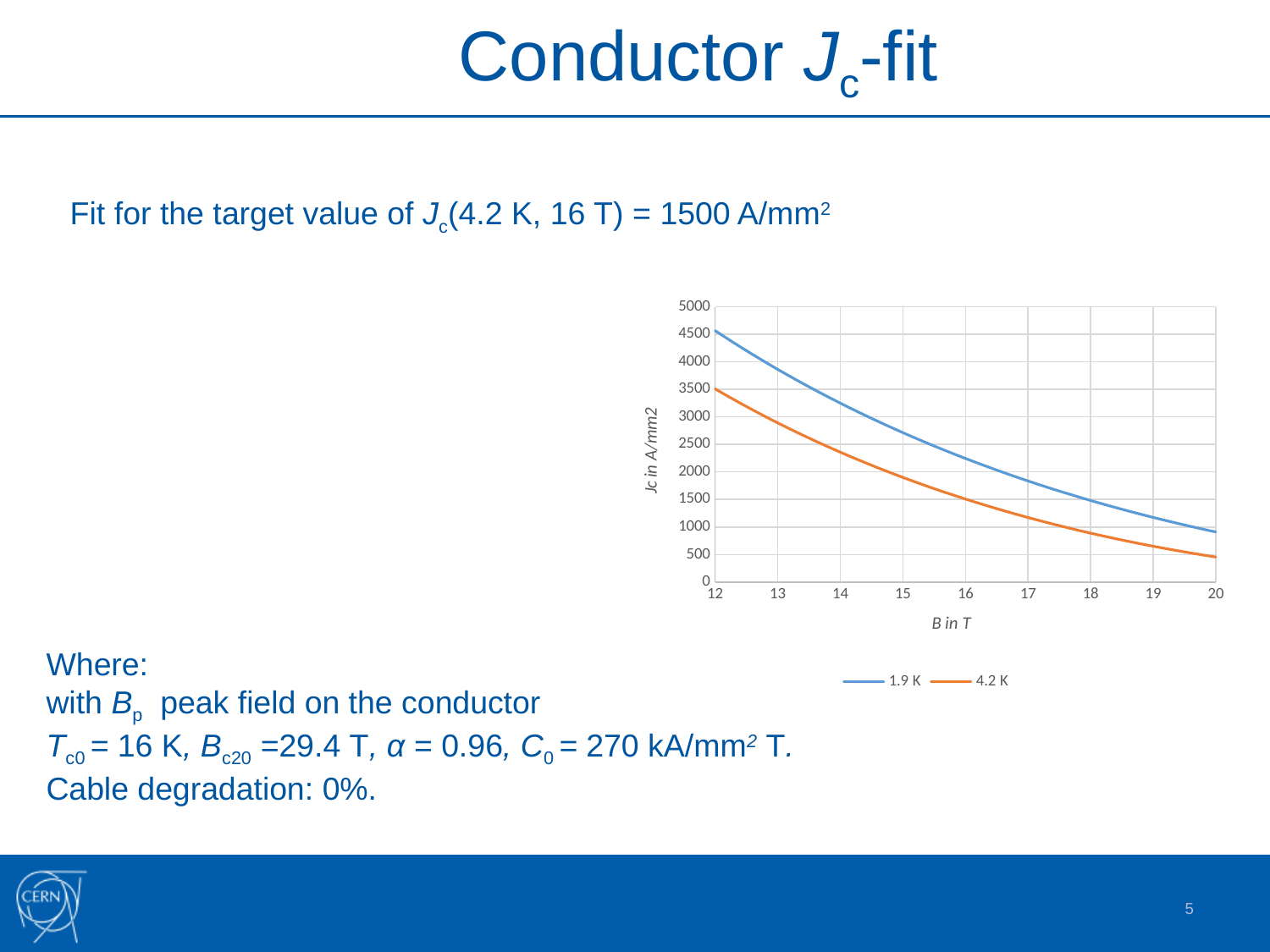
What is the title of the x axis of the chart? B in T Is the value of the 1.9 K series at B = 20 T greater or less than 1000? less Is the value of the 4.2 K series at B = 14 T greater or less than 2000? greater Is the value of the 4.2 K series at B = 20 T greater or less than 1000? less At B = 16 T, which series has the larger Jc value, 1.9 K or 4.2 K? 1.9 K What kind of chart is shown on the slide? line chart What is the value of Jc for the 4.2 K series at B = 16 T? 1500 A/mm2 Which two series are listed in the chart legend? 1.9 K and 4.2 K Do the Jc values rise or fall as B increases along the x axis? fall How many series does the chart legend list? 2